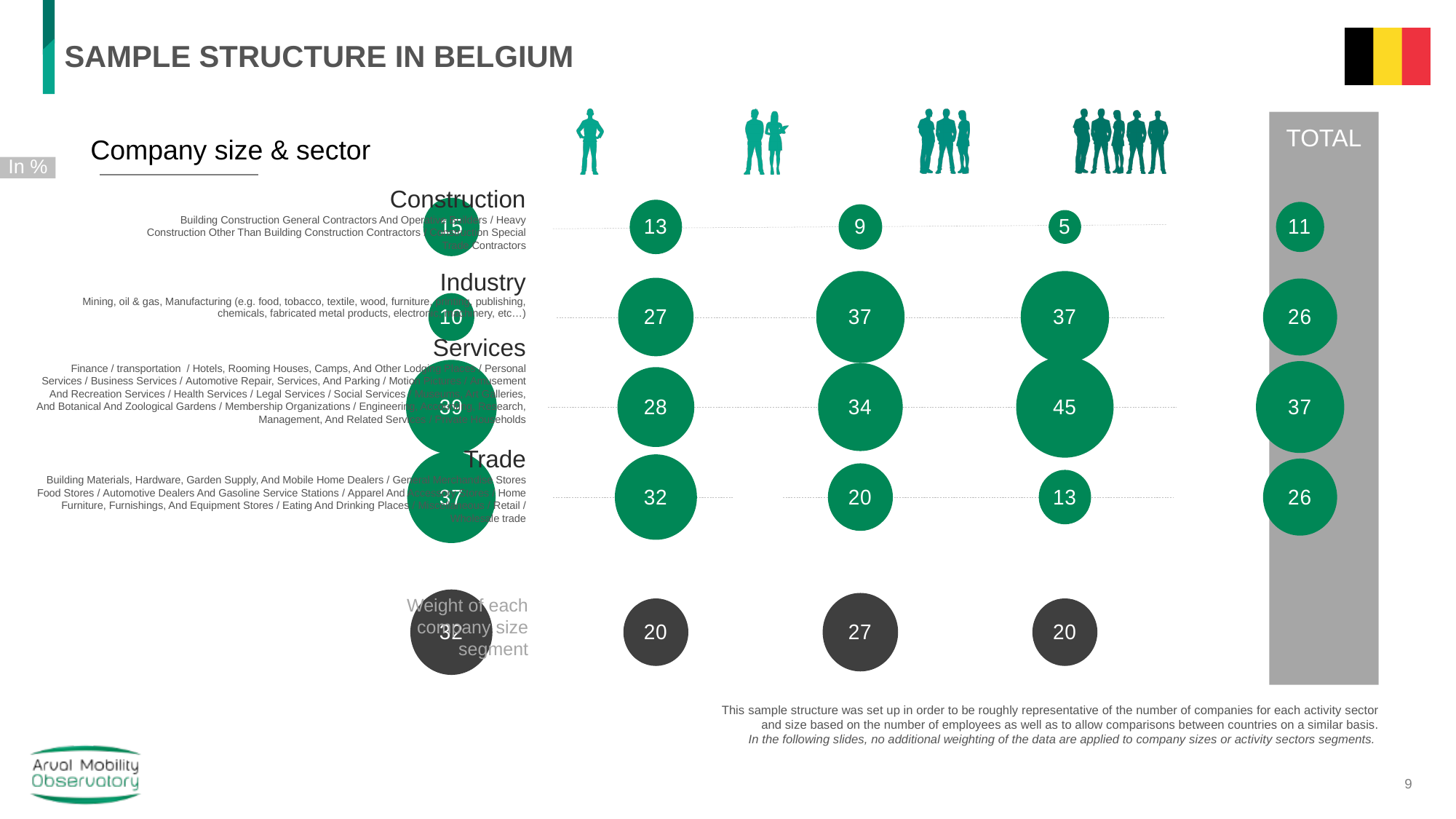
Which sector has the lowest value in the TOTAL column? Construction How many sectors are shown in the chart? 4 What is the TOTAL value for Construction? 11 In the second company-size column, which is larger: Industry or Trade? Trade What is the value for Services in the fourth company-size column (the last one before TOTAL)? 45 What kind of chart is used on this slide? Bubble chart What is the weight of the third company-size segment in the bottom row? 27 What is the difference between the TOTAL values for Industry and Construction? 15 Which company-size segment has the largest weight in the bottom row? The first (leftmost) segment, 32 Which sector has the highest value in the TOTAL column? Services What is the TOTAL value for Services? 37 Do the Construction values rise or fall moving from the first company-size column to the fourth? Fall